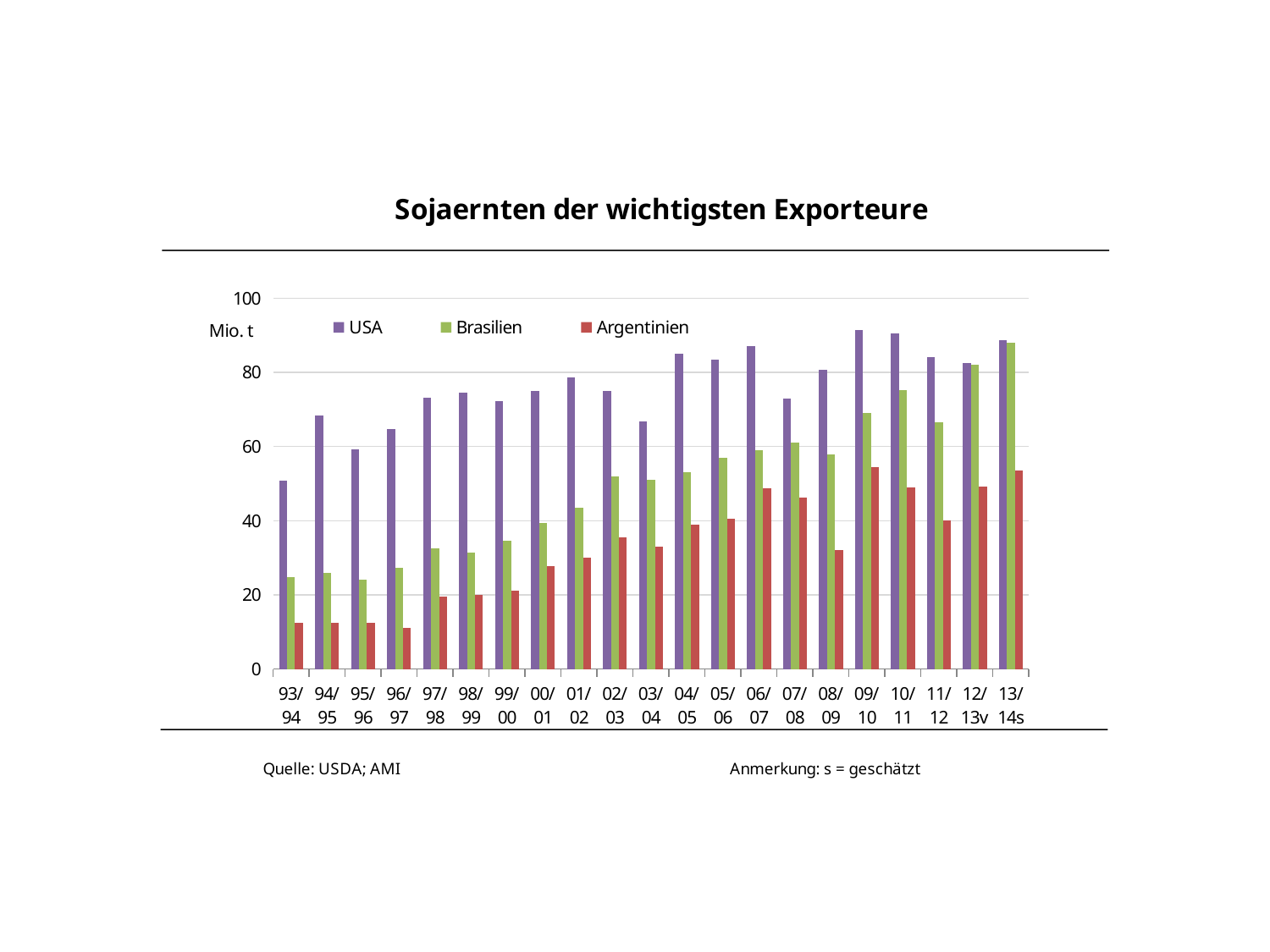
In which year is the Brasilien value highest? 13/14s Is the value for Argentinien in 09/10 greater or less than 40? greater Is the value for Argentinien in 93/94 greater or less than 20? less Does the Brasilien series generally rise or fall from 93/94 to 13/14s? rise Is the value for Brasilien in 13/14s greater or less than 80? greater What unit is shown on the y axis of the chart? Mio. t How many series does the legend list? 3 In which year is the USA value lowest? 93/94 How many marketing years (categories) are shown on the x axis? 21 In 93/94, which is larger: the value for USA or for Brasilien? USA What type of chart is shown on the slide? bar chart